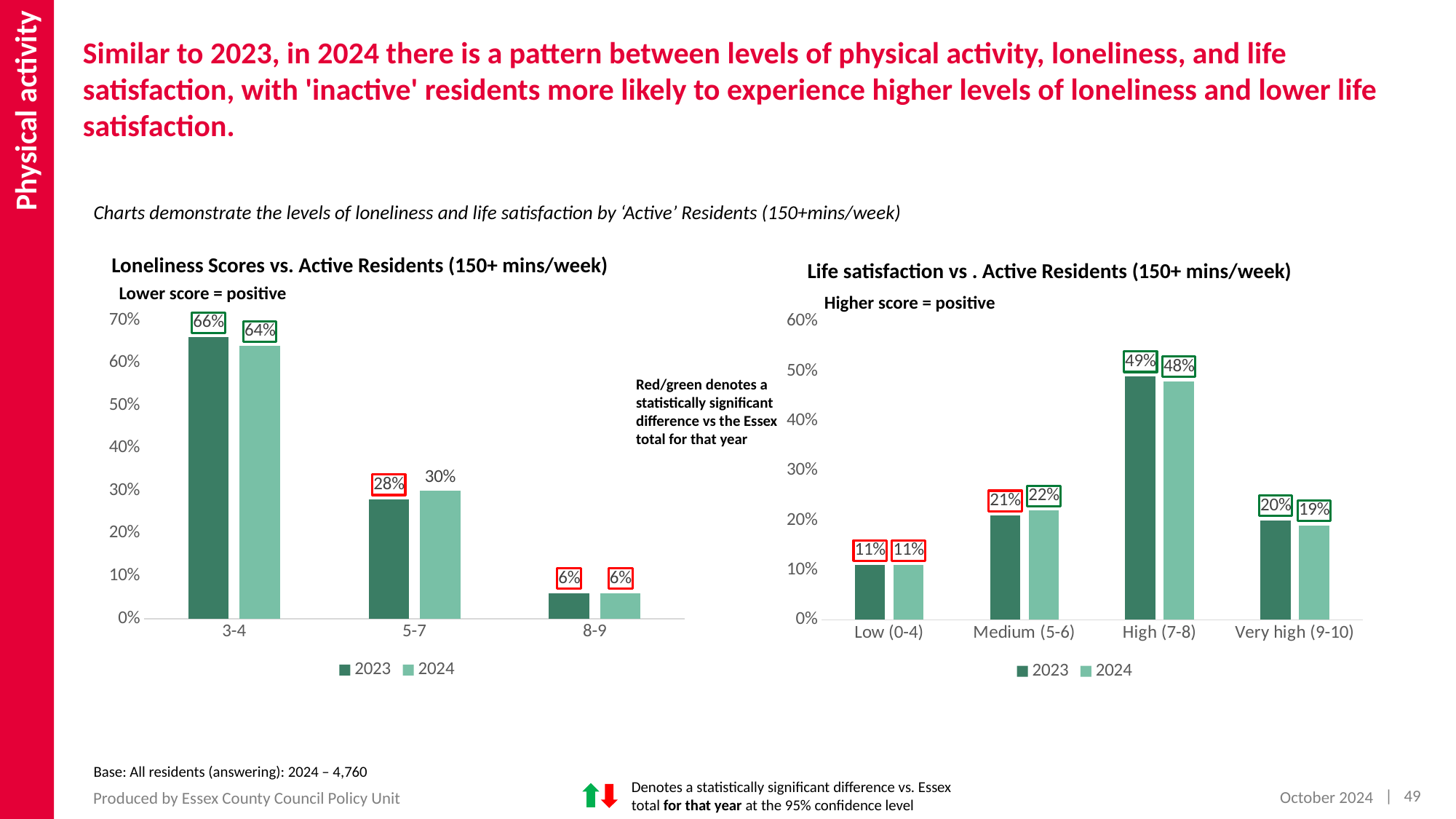
In the Life satisfaction vs. Active Residents chart, which category has the lowest 2024 value? Low (0-4) How many categories are shown on the x axis of the Life satisfaction vs. Active Residents chart? 4 In the Life satisfaction vs. Active Residents chart, what is the 2023 value for High (7-8)? 49% How many series does the legend of the Loneliness Scores vs. Active Residents chart list? 2 In the Loneliness Scores vs. Active Residents chart, is the 2024 value for 5-7 larger or smaller than the 2023 value for 5-7? larger In the Loneliness Scores vs. Active Residents chart, which category has the highest 2023 value? 3-4 In the Loneliness Scores vs. Active Residents chart, what is the 2023 value for the 5-7 category? 28% In the Life satisfaction vs. Active Residents chart, what is the 2024 value for Very high (9-10)? 19% In the Loneliness Scores vs. Active Residents chart, what is the difference between the 2023 and 2024 values for the 3-4 category? 2% In the Life satisfaction vs. Active Residents chart, what is the difference between the High (7-8) and Medium (5-6) values for 2024? 26% In the Loneliness Scores vs. Active Residents chart, what is the 2024 value for the 3-4 category? 64% What type of chart is the Life satisfaction vs. Active Residents chart? bar chart